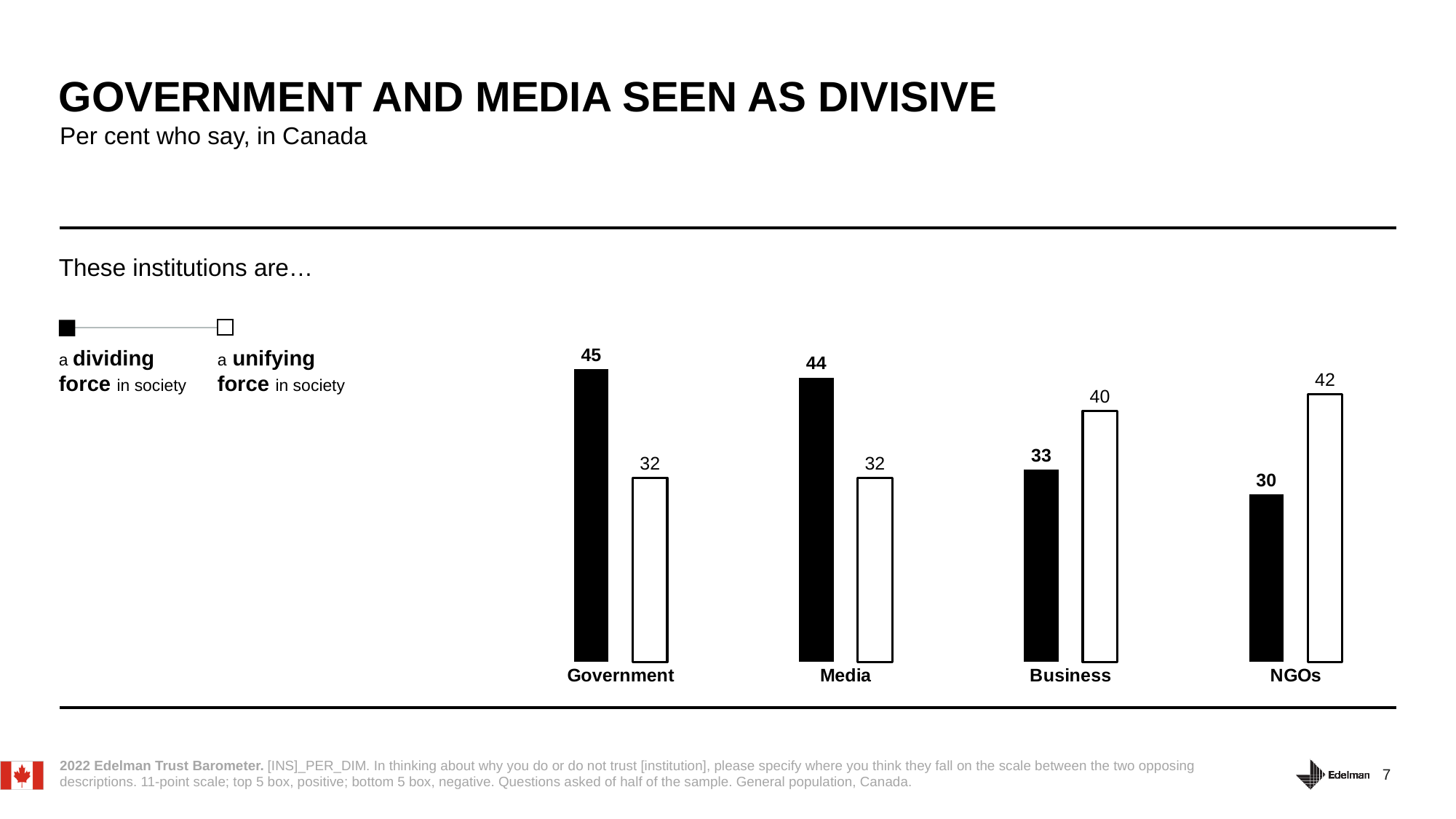
What is the difference between the unifying force values for NGOs and Media? 10 For Business, which is larger: the per cent saying it is a dividing force or a unifying force? a unifying force What per cent say NGOs are a unifying force in society? 42 Which institution has the highest per cent saying it is a dividing force in society? Government What is the difference between the dividing force and unifying force values for Government? 13 What per cent say Business is a dividing force in society? 33 What kind of chart is shown on the slide? bar chart How many institutions are shown on the chart? 4 How many series does the legend list? 2 Which institution has the highest per cent saying it is a unifying force in society? NGOs What per cent say Government is a dividing force in society? 45 Which institution has the lowest per cent saying it is a dividing force in society? NGOs